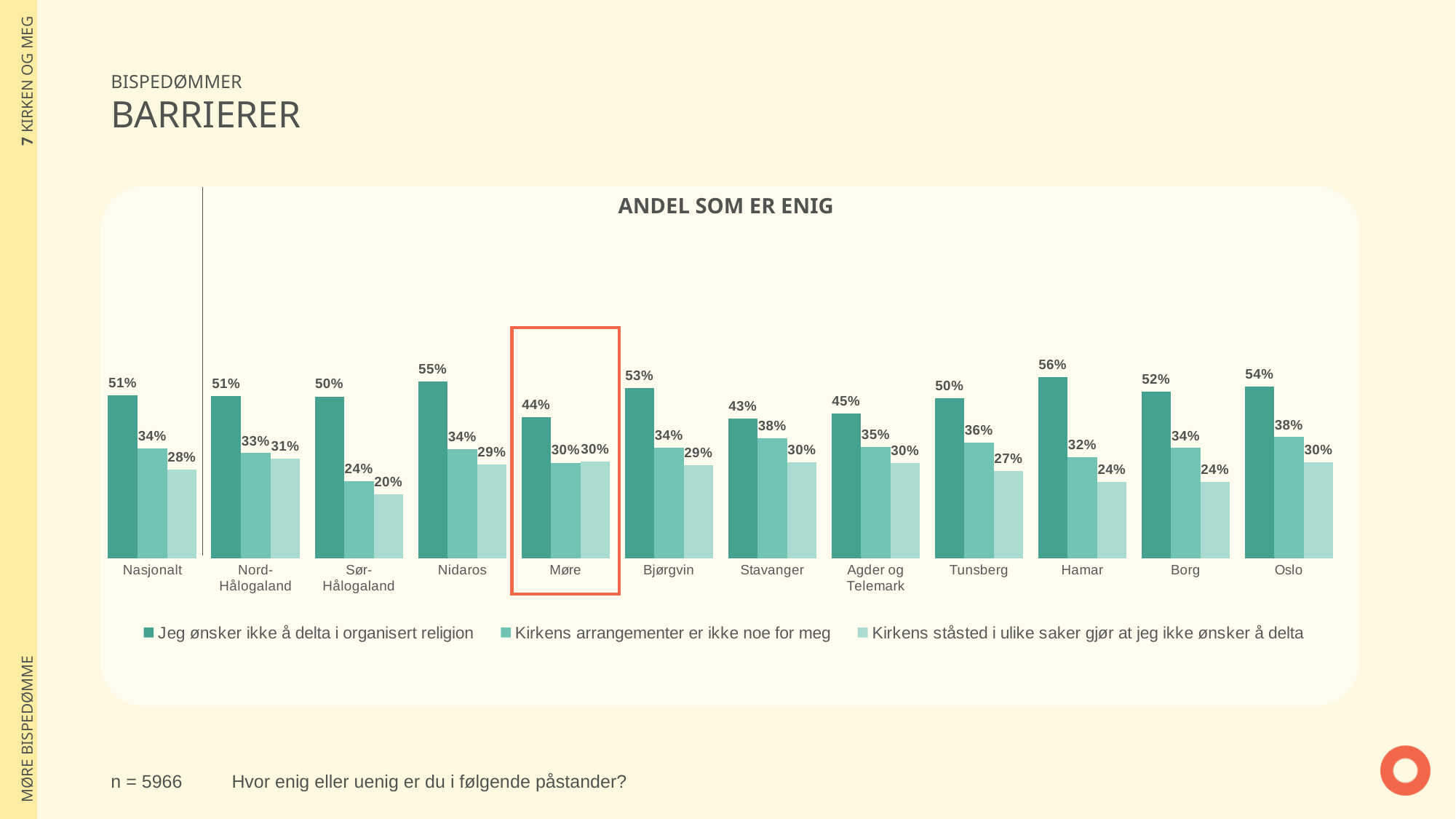
What is the title of the chart? ANDEL SOM ER ENIG Which category has the lowest value for 'Jeg ønsker ikke å delta i organisert religion'? Stavanger What is the difference between Hamar and Møre for 'Jeg ønsker ikke å delta i organisert religion'? 12% Which category has the lowest value for 'Kirkens ståsted i ulike saker gjør at jeg ikke ønsker å delta'? Sør-Hålogaland How many categories are shown on the x axis? 12 What is the value for Sør-Hålogaland for the series 'Kirkens ståsted i ulike saker gjør at jeg ikke ønsker å delta'? 20% What is the value for Stavanger for the series 'Kirkens arrangementer er ikke noe for meg'? 38% Which is larger for 'Kirkens arrangementer er ikke noe for meg': Tunsberg or Hamar? Tunsberg How many series does the legend list? 3 Which category has the highest value for 'Jeg ønsker ikke å delta i organisert religion'? Hamar What is the value for Møre for the series 'Jeg ønsker ikke å delta i organisert religion'? 44% What kind of chart is shown on the slide? bar chart